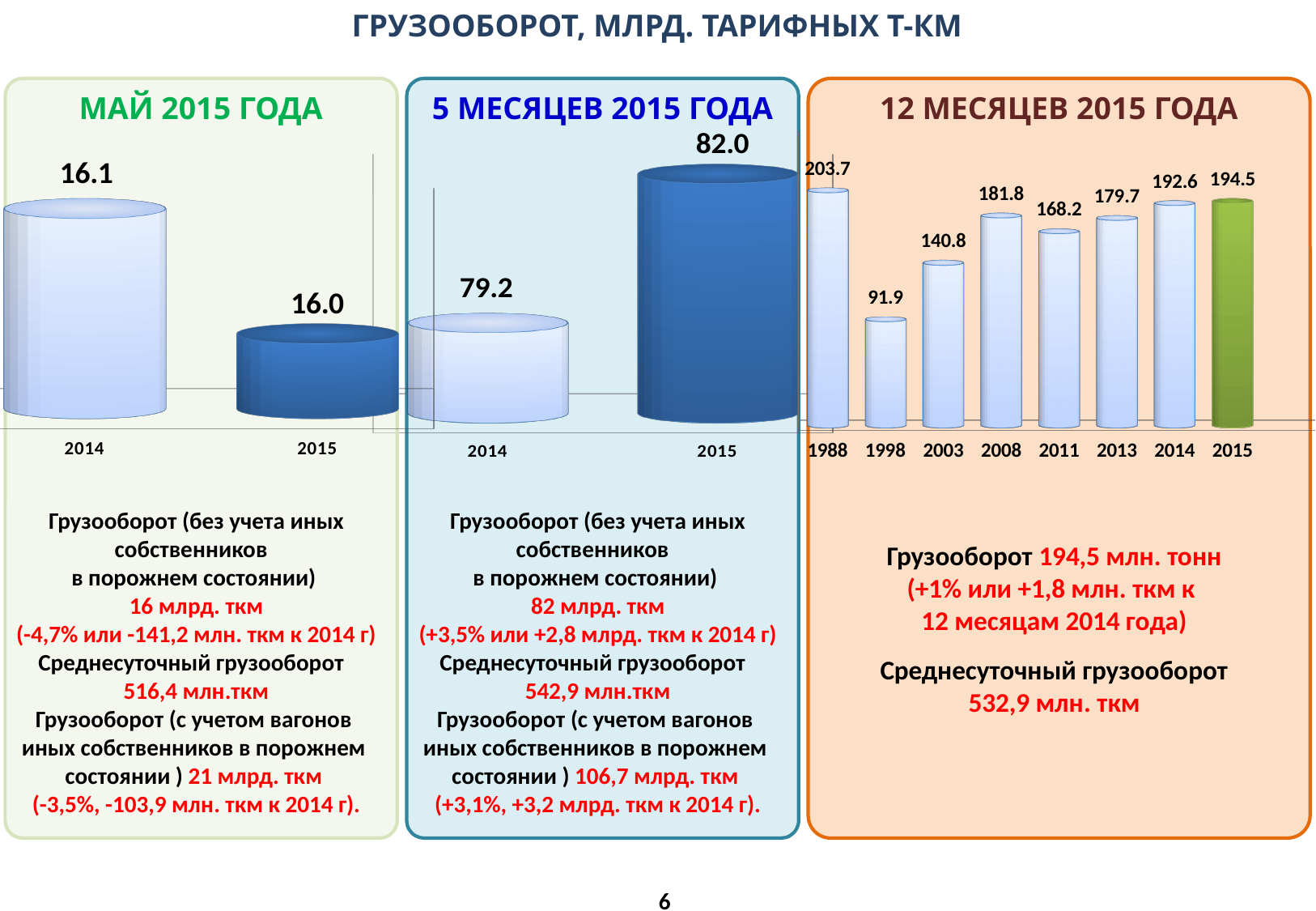
In the chart titled "12 МЕСЯЦЕВ 2015 ГОДА", how many years are shown on the x axis? 8 In the chart titled "5 МЕСЯЦЕВ 2015 ГОДА", what is the value for 2015? 82.0 In the chart titled "12 МЕСЯЦЕВ 2015 ГОДА", what is the value for 2011? 168.2 What kind of chart is the one titled "12 МЕСЯЦЕВ 2015 ГОДА"? Bar chart In the chart titled "12 МЕСЯЦЕВ 2015 ГОДА", what is the value for 2003? 140.8 In the chart titled "МАЙ 2015 ГОДА", what is the value for 2015? 16.0 In the chart titled "МАЙ 2015 ГОДА", what is the value for 2014? 16.1 In the chart titled "12 МЕСЯЦЕВ 2015 ГОДА", which year has the highest value? 1988 In the chart titled "12 МЕСЯЦЕВ 2015 ГОДА", which year has the lowest value? 1998 In the chart titled "12 МЕСЯЦЕВ 2015 ГОДА", what is the difference between the 2015 and 2014 values? 1.9 In the chart titled "5 МЕСЯЦЕВ 2015 ГОДА", what is the difference between the 2015 and 2014 values? 2.8 In the chart titled "5 МЕСЯЦЕВ 2015 ГОДА", which year has the larger value, 2014 or 2015? 2015